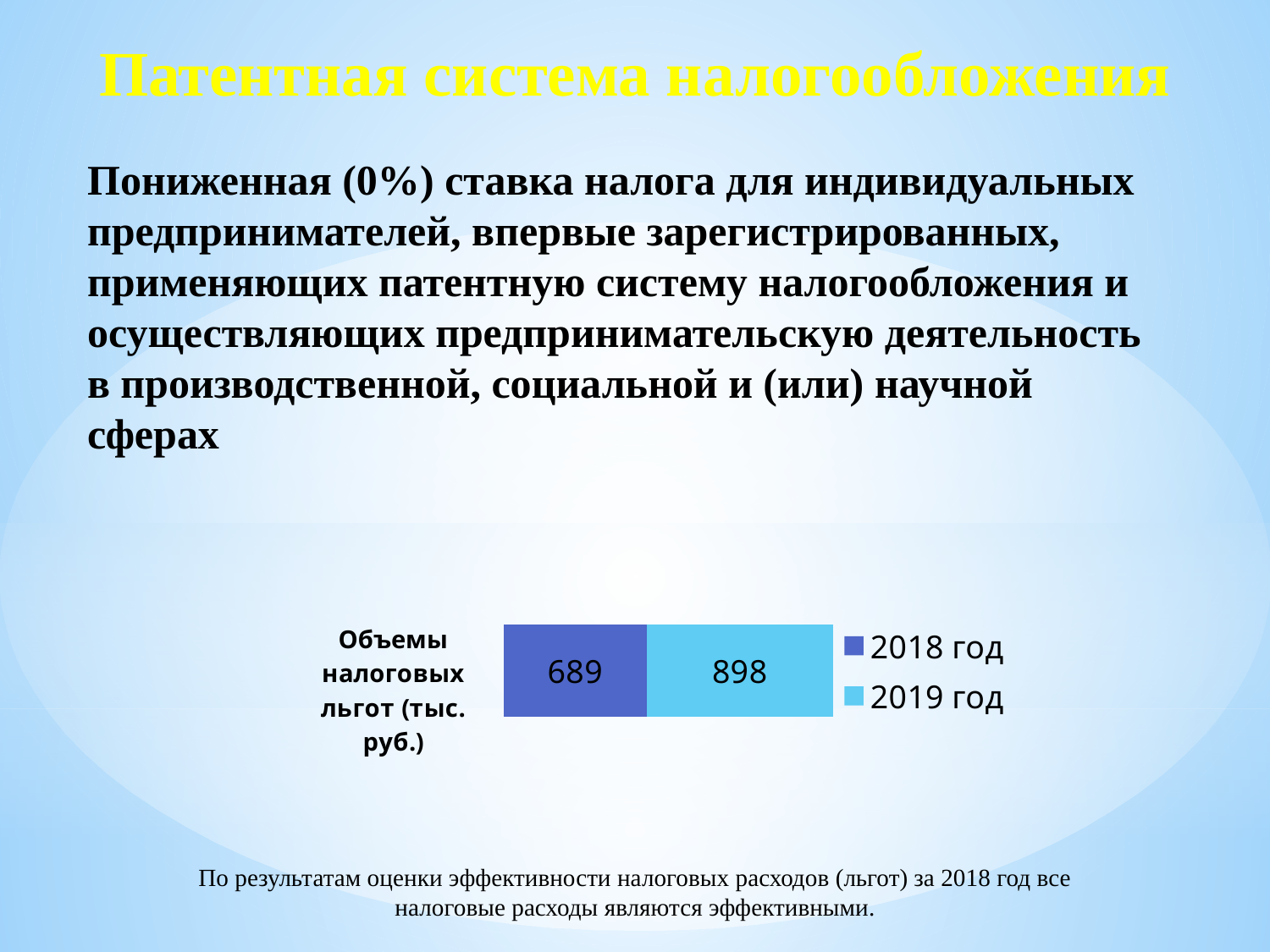
Did the volume of tax benefits rise or fall from 2018 год to 2019 год? Rise What is the difference between the 2019 год and 2018 год values? 209 What is the value for 2019 год in the chart? 898 What kind of chart is shown on the slide? Stacked bar chart How many series does the legend list? 2 How many categories are plotted in the chart? 1 Which series has the larger value, 2018 год or 2019 год? 2019 год Which series is shown in the lighter blue colour? 2019 год What is the category label of the bar in the chart? Объемы налоговых льгот (тыс. руб.) What is the total of the stacked bar? 1587 What is the value for 2018 год in the chart? 689